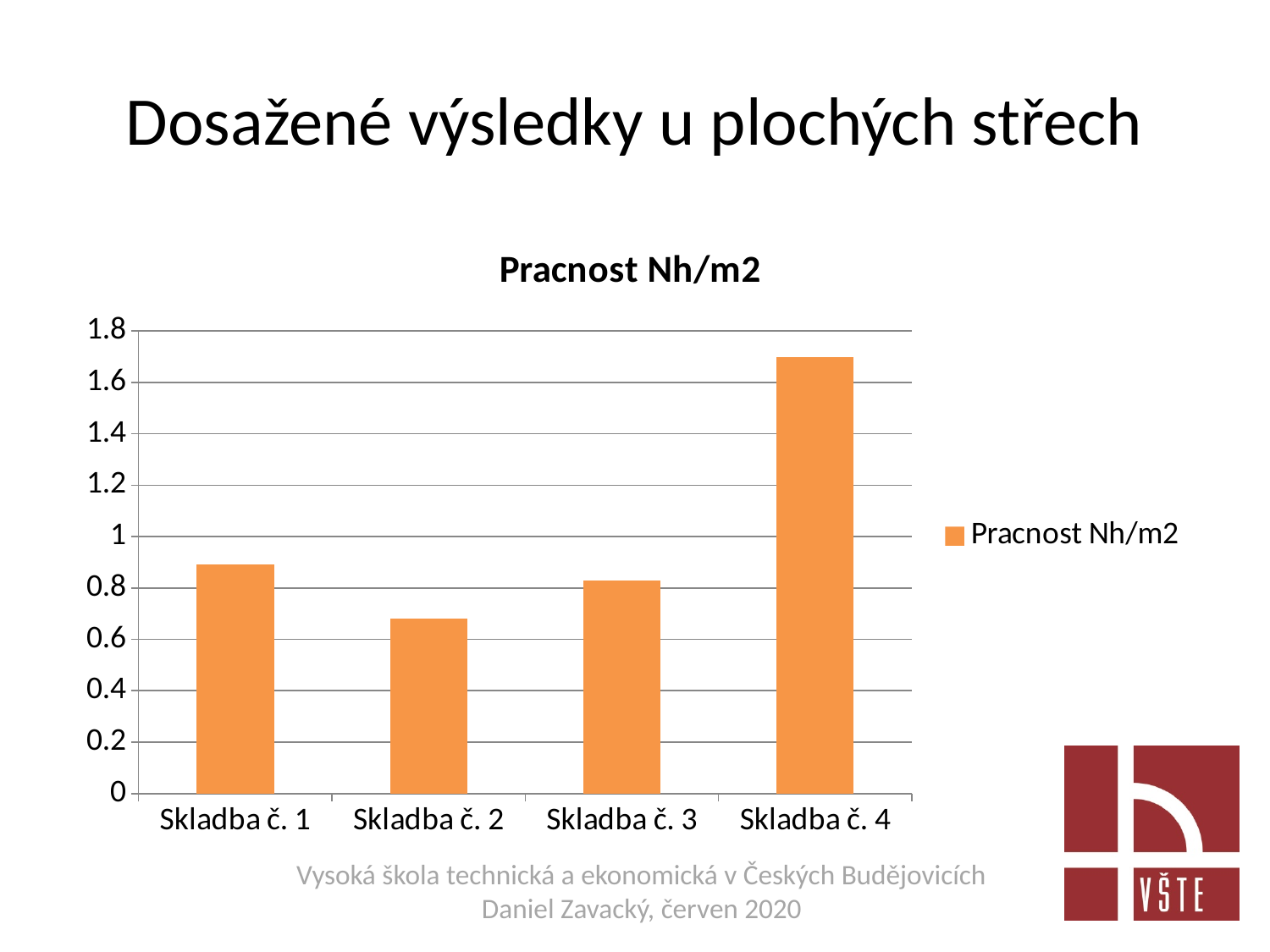
Is the value for Skladba č. 3 greater or less than 0.6? greater What is the title of the chart? Pracnost Nh/m2 How many series does the legend list? 1 Is the value for Skladba č. 1 greater or less than 1? less How many categories are shown on the x axis of the chart? 4 What kind of chart is shown on the slide? bar chart Which is larger, the value for Skladba č. 1 or Skladba č. 2? Skladba č. 1 Which category has the lowest value? Skladba č. 2 Is the value for Skladba č. 2 greater or less than 0.8? less Which category has the highest value? Skladba č. 4 Which is larger, the value for Skladba č. 3 or Skladba č. 4? Skladba č. 4